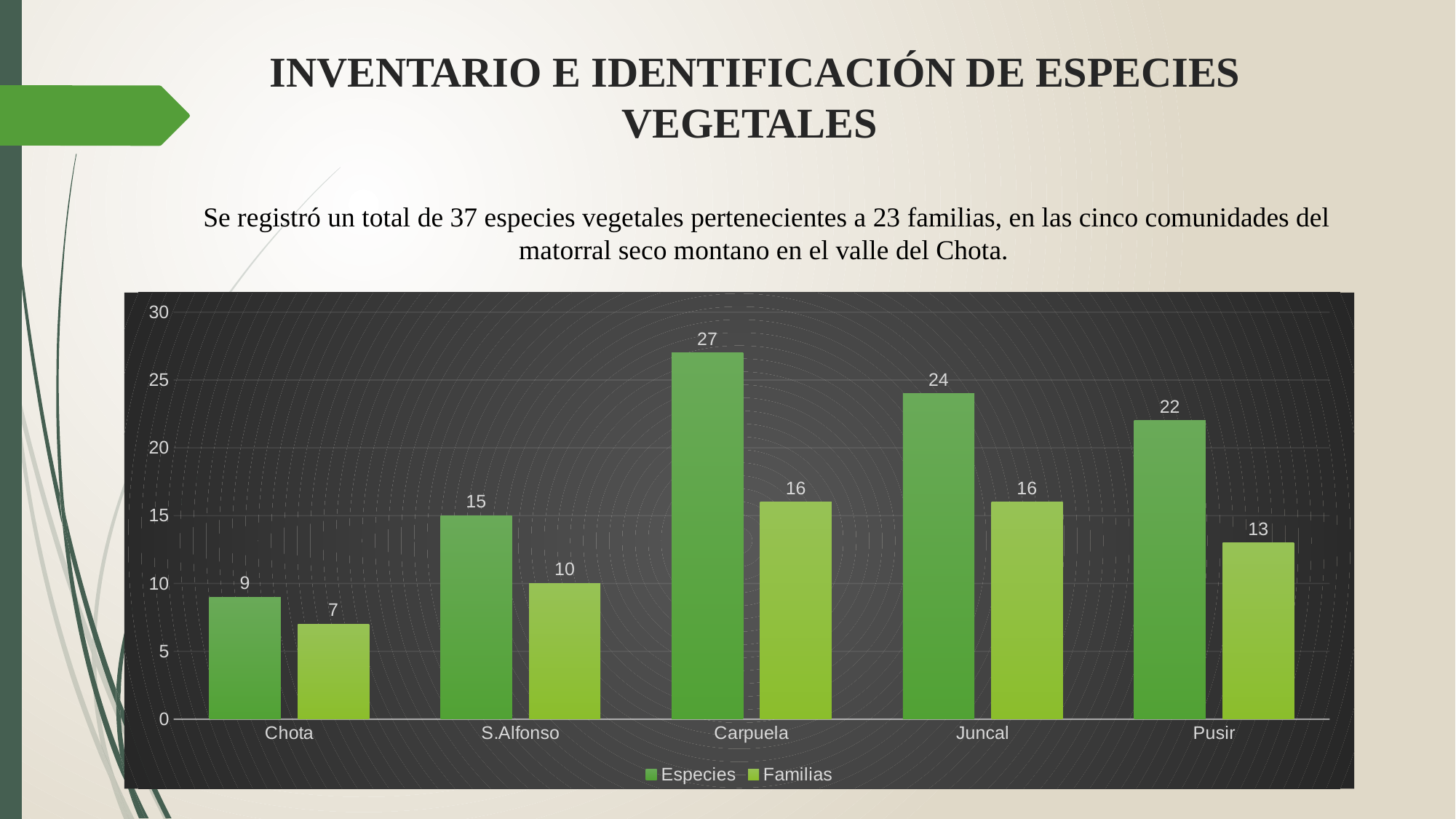
How many communities are shown on the x axis? 5 How many series does the legend list? 2 What is the difference between the Especies and Familias values for Juncal? 8 Is the Especies value for Juncal greater or less than 20? greater What is the Especies value for Pusir? 22 What are the two series named in the legend? Especies and Familias Which community has the lowest Familias value? Chota Which is larger, the Especies value for S.Alfonso or the Especies value for Pusir? Pusir What is the Familias value for Chota? 7 Which community has the highest Especies value? Carpuela What kind of chart is shown on the slide? bar chart What is the Especies value for Carpuela? 27